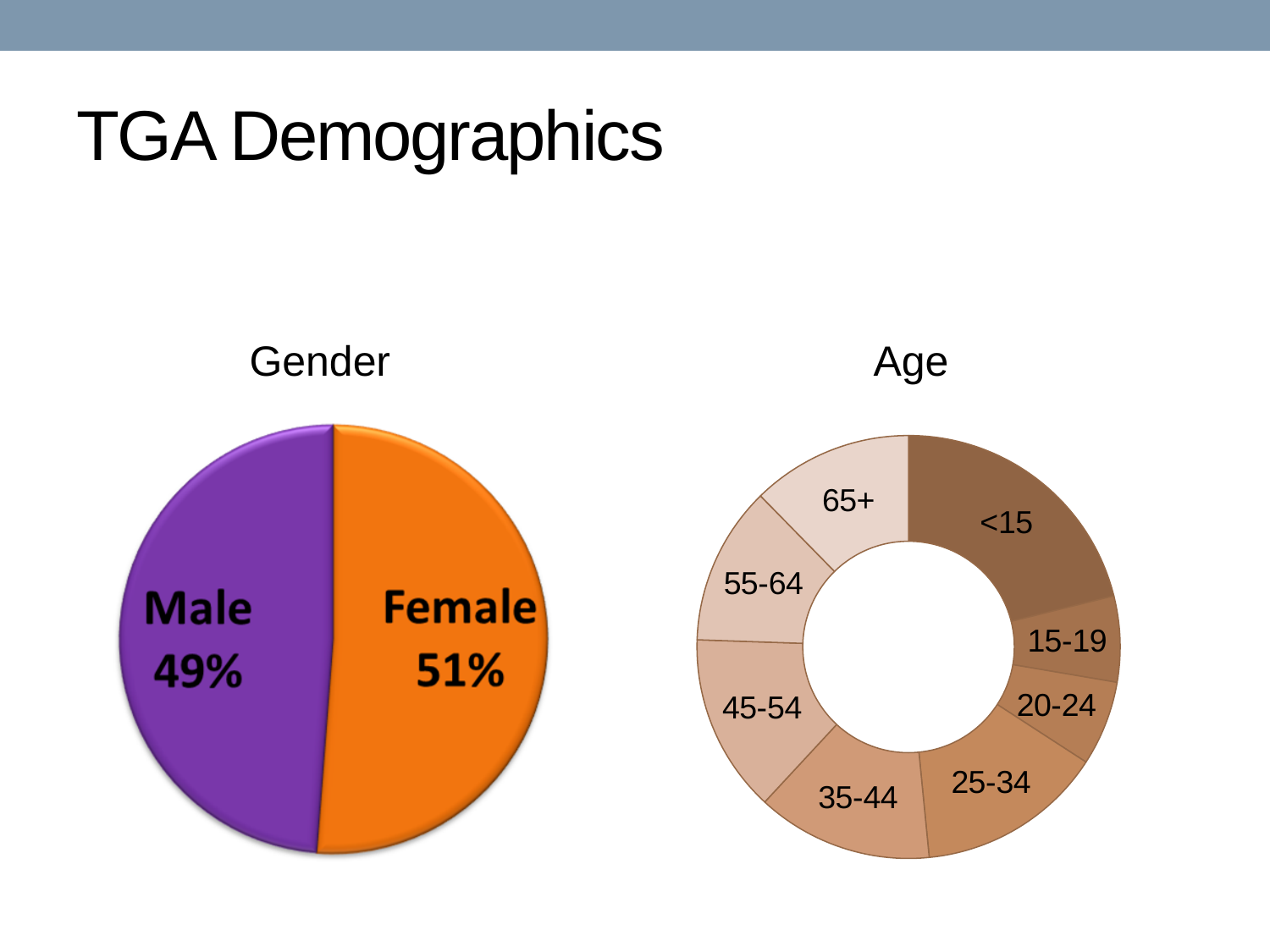
In the Age chart, how many age categories are shown? 8 In the Gender chart, is the Male share larger or smaller than the Female share? smaller What kind of chart is the Age chart? doughnut chart What kind of chart is the Gender chart? pie chart In the Gender chart, which category has the smaller share? Male In the Age chart, which age category has the largest share? <15 In the Gender chart, what percentage is Male? 49% In the Gender chart, what percentage is Female? 51% In the Gender chart, what colour is the Male slice? purple In the Gender chart, how many slices are there? 2 In the Gender chart, which category has the larger share? Female In the Gender chart, what is the difference between the Female and Male percentages? 2%